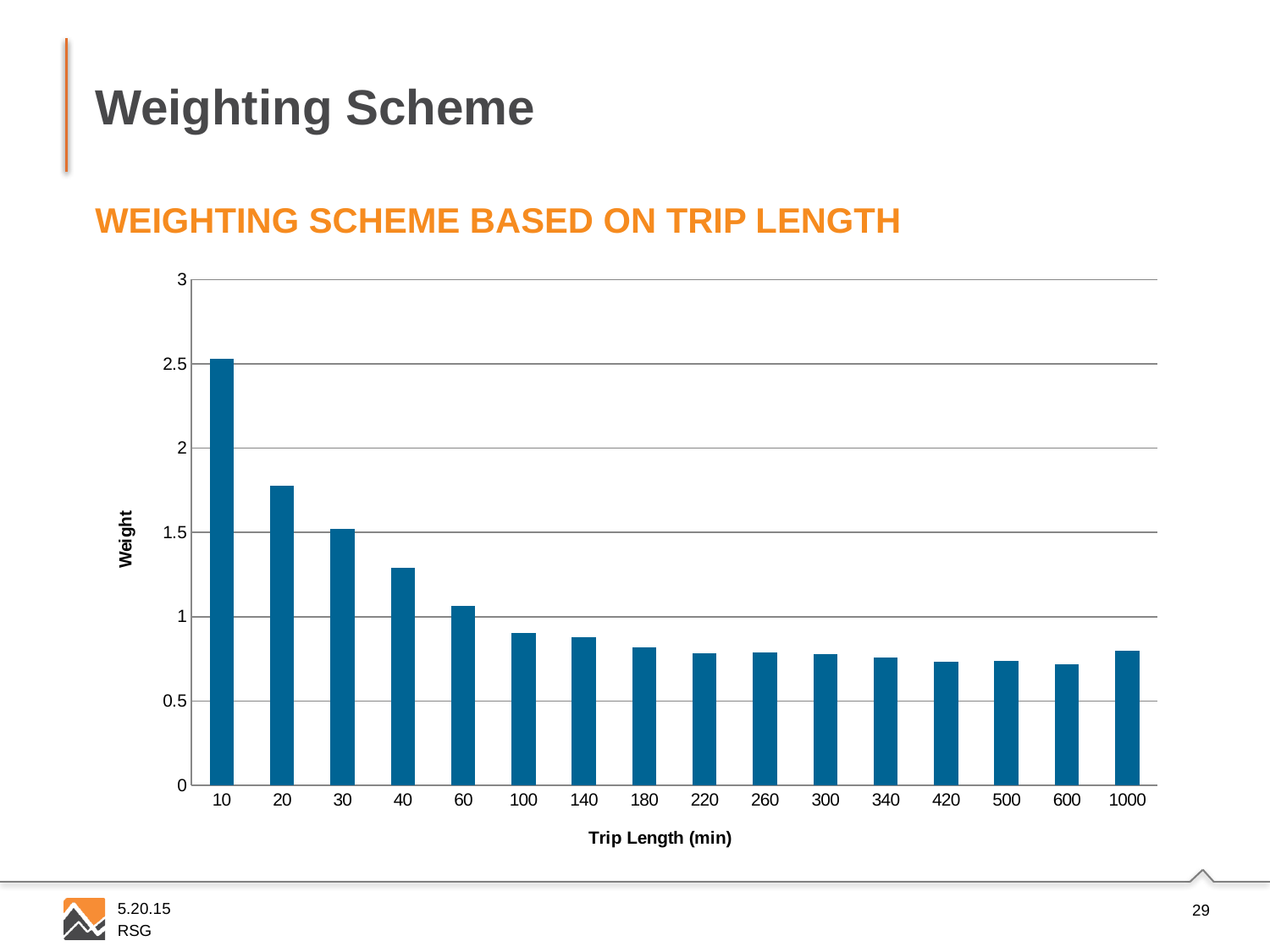
Is the weight for trip length 1000 greater or less than 0.5? greater Is the weight for trip length 100 greater or less than 1? less Do the weights generally rise or fall as trip length increases along the x axis? fall What kind of chart is shown on the slide? bar chart Is the weight for trip length 40 greater or less than 1.5? less How many trip length categories are shown on the x axis? 16 Which has a larger weight, trip length 30 or trip length 60? 30 Which trip length has the highest weight? 10 What is the label of the x axis? Trip Length (min)